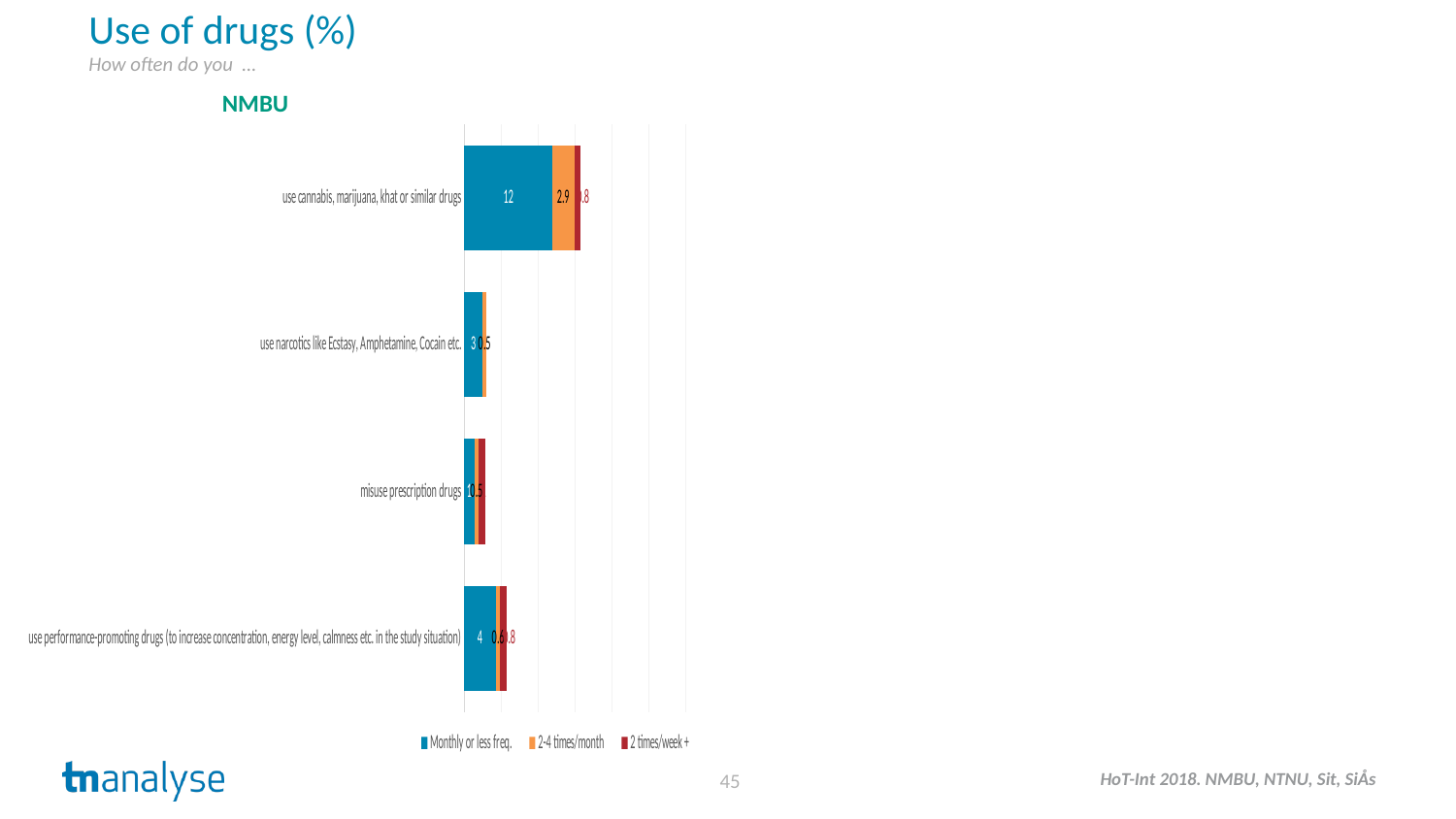
What is the 'Monthly or less freq.' value for 'use narcotics like Ecstasy, Amphetamine, Cocain etc.'? 3 What is the '2-4 times/month' value for 'use cannabis, marijuana, khat or similar drugs'? 2.9 What is the 'Monthly or less freq.' value for 'use performance-promoting drugs'? 4 What is the difference between the 'Monthly or less freq.' values for cannabis and performance-promoting drugs? 8 What kind of chart is shown on the slide? bar chart Which is larger: the 'Monthly or less freq.' value for narcotics or for performance-promoting drugs? performance-promoting drugs How many categories are plotted in the chart? 4 How many series does the legend list? 3 What is the title shown above the chart? NMBU Which category has the lowest 'Monthly or less freq.' value? misuse prescription drugs What is the 'Monthly or less freq.' value for 'use cannabis, marijuana, khat or similar drugs'? 12 Which category has the highest 'Monthly or less freq.' value? use cannabis, marijuana, khat or similar drugs